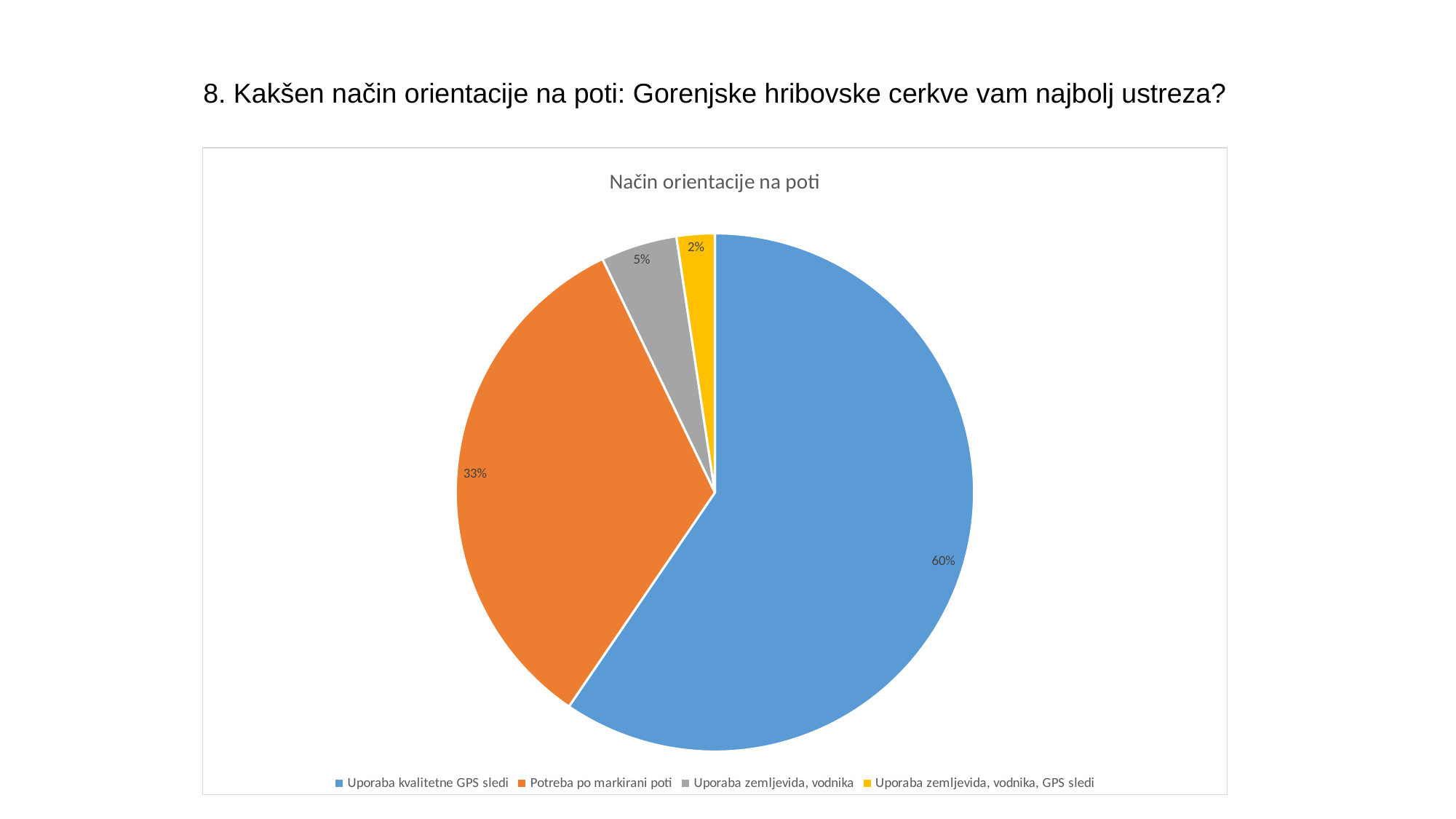
Which is larger: the slice for "Uporaba zemljevida, vodnika" or the slice for "Uporaba zemljevida, vodnika, GPS sledi"? Uporaba zemljevida, vodnika What share of the pie does "Uporaba kvalitetne GPS sledi" have? 60% What is the title of the chart? Način orientacije na poti What share of the pie does "Potreba po markirani poti" have? 33% What is the difference in percentage points between "Uporaba kvalitetne GPS sledi" and "Potreba po markirani poti"? 27 What colour is the slice for "Potreba po markirani poti"? orange What share of the pie does "Uporaba zemljevida, vodnika, GPS sledi" have? 2% What type of chart is shown on the slide? pie chart Which category has the smallest slice of the pie? Uporaba zemljevida, vodnika, GPS sledi How many categories does the pie chart show? 4 Which category has the largest slice of the pie? Uporaba kvalitetne GPS sledi